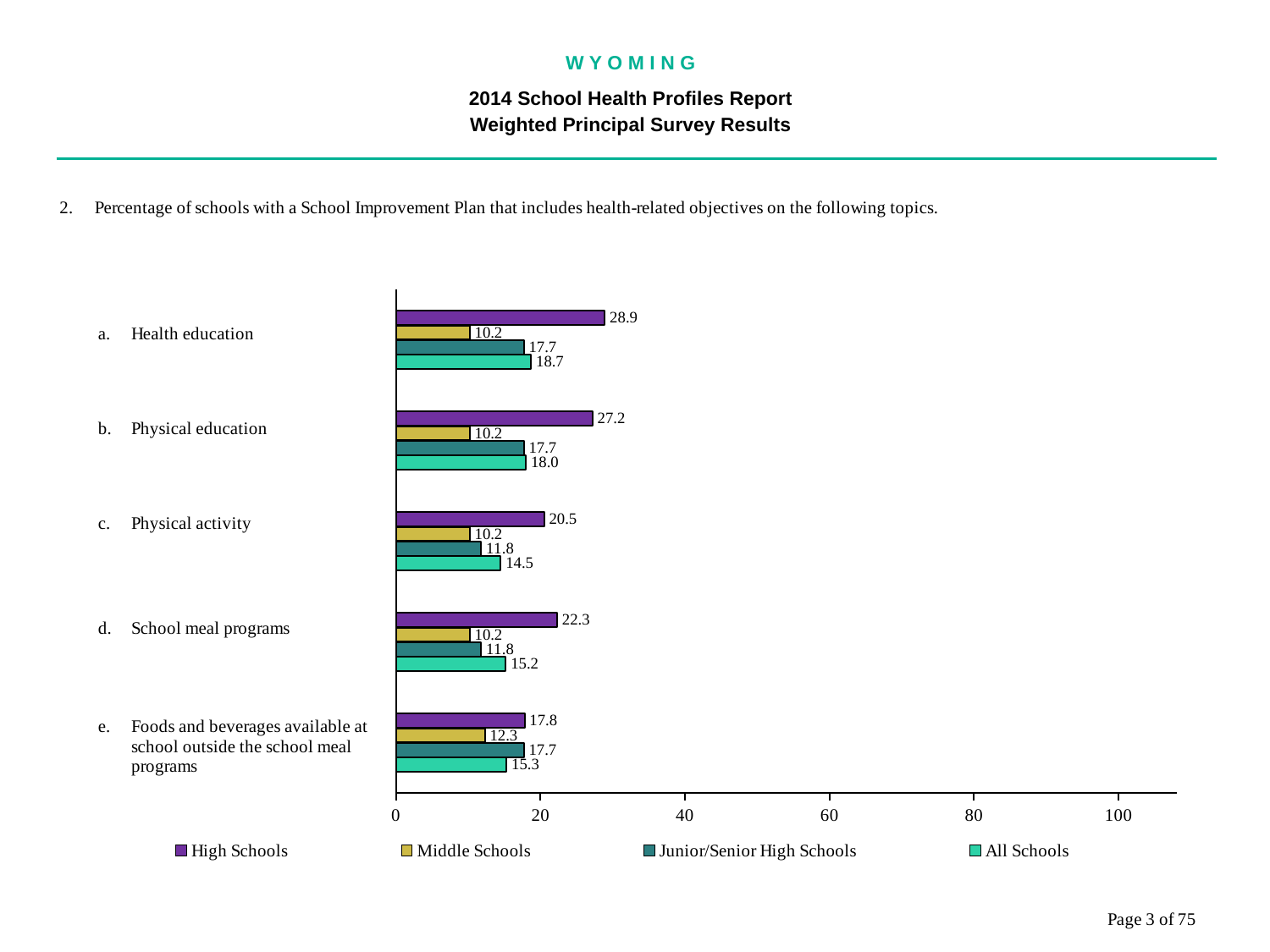
What is the value for All Schools for Physical activity? 14.5 Which topic has the lowest value for All Schools? Physical activity What is the value for Junior/Senior High Schools for School meal programs? 11.8 What kind of chart is shown on the slide? bar chart What is the value for High Schools for Health education? 28.9 What is the difference between the High Schools and Middle Schools values for Physical education? 17.0 How many topics are shown on the chart? 5 Which is larger for School meal programs: the High Schools value or the All Schools value? High Schools How many series does the legend list? 4 Is the High Schools value for Health education greater or less than 20? greater What is the value for Middle Schools for Foods and beverages available at school outside the school meal programs? 12.3 Which topic has the highest value for High Schools? Health education